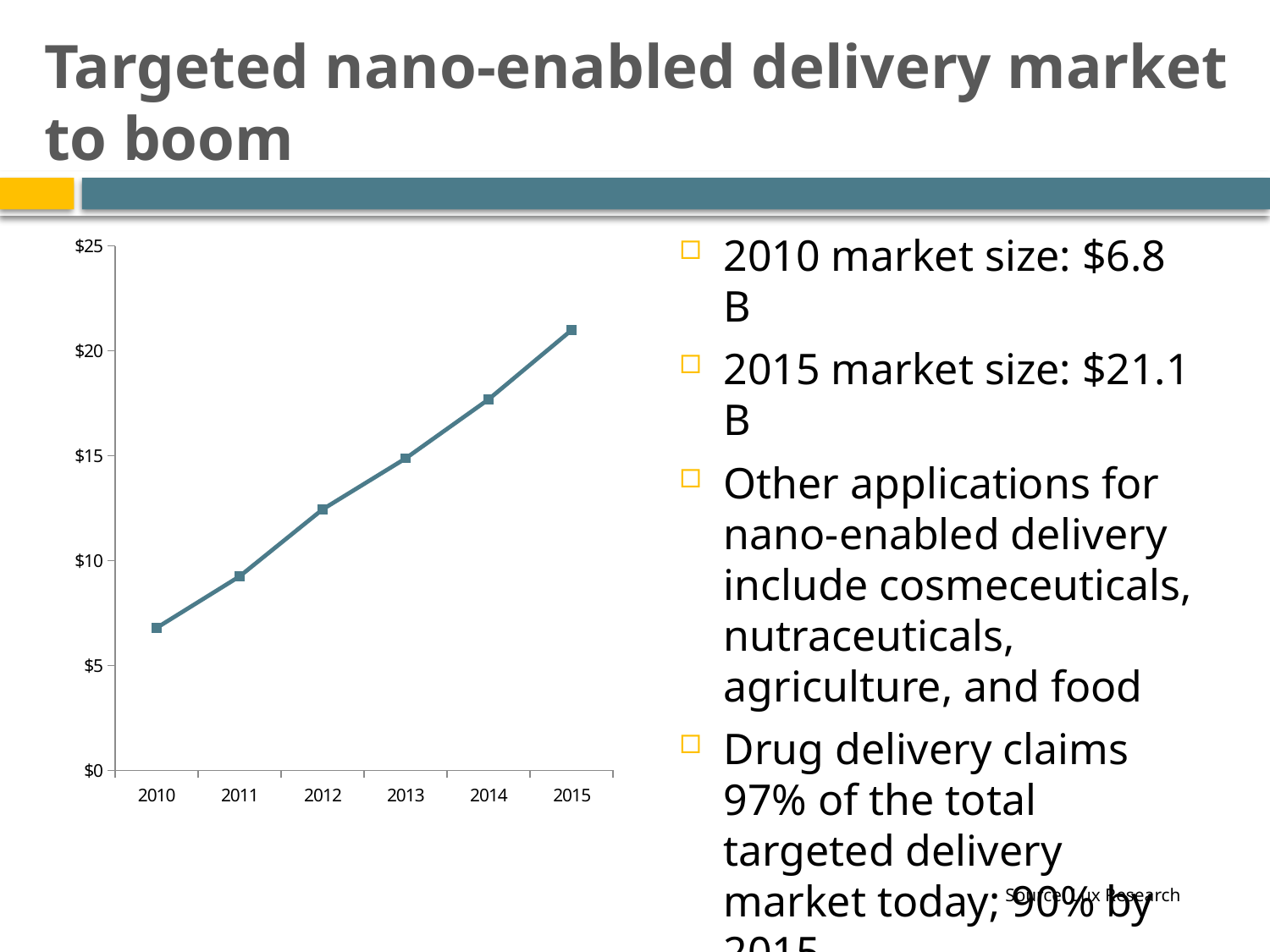
According to the slide, what is the market size plotted for 2010? $6.8 B Is the value for 2010 greater or less than $10? less What kind of chart is shown on the slide? line chart Which is larger, the value for 2014 or the value for 2012? 2014 Is the value for 2014 greater or less than $15? greater Do the plotted values rise or fall from 2010 to 2015? rise How many years are plotted on the x axis of the chart? 6 Which year has the highest value on the chart? 2015 Is the value for 2015 greater or less than $20? greater According to the slide, what is the market size plotted for 2015? $21.1 B Which year has the lowest value on the chart? 2010